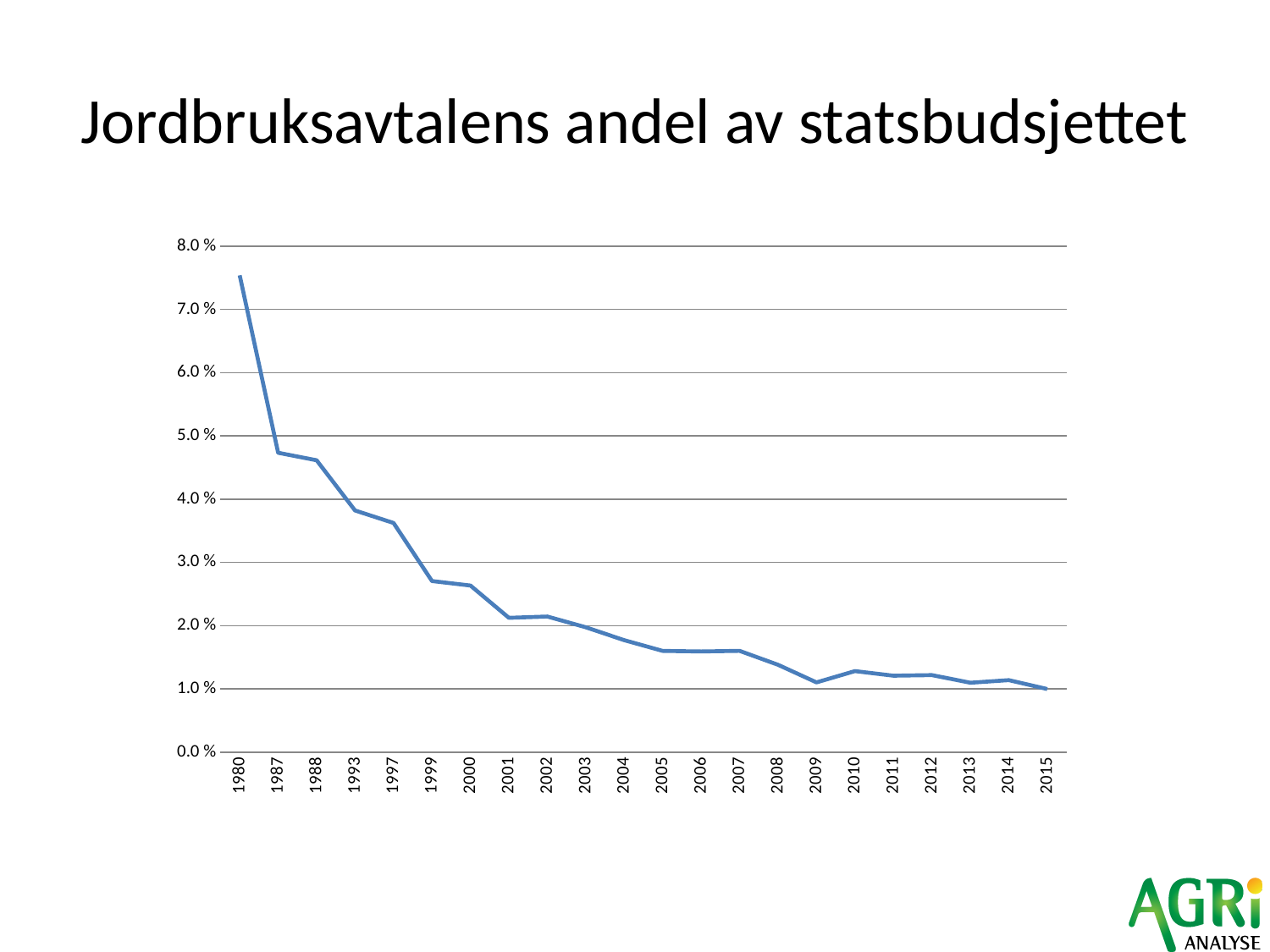
Which is larger, the value for 1988 or the value for 1993? 1988 Do the values generally rise or fall from 1980 to 2015? fall Which is larger, the value for 2000 or the value for 2003? 2000 What kind of chart is shown on the slide? line chart What is the title of the chart? Jordbruksavtalens andel av statsbudsjettet Is the value for 1987 greater or less than 5.0 %? less Which year has the lowest value? 2015 How many years are plotted along the x axis? 22 Is the value for 1999 greater or less than 3.0 %? less Is the value for 1980 greater or less than 7.0 %? greater Which year has the highest value? 1980